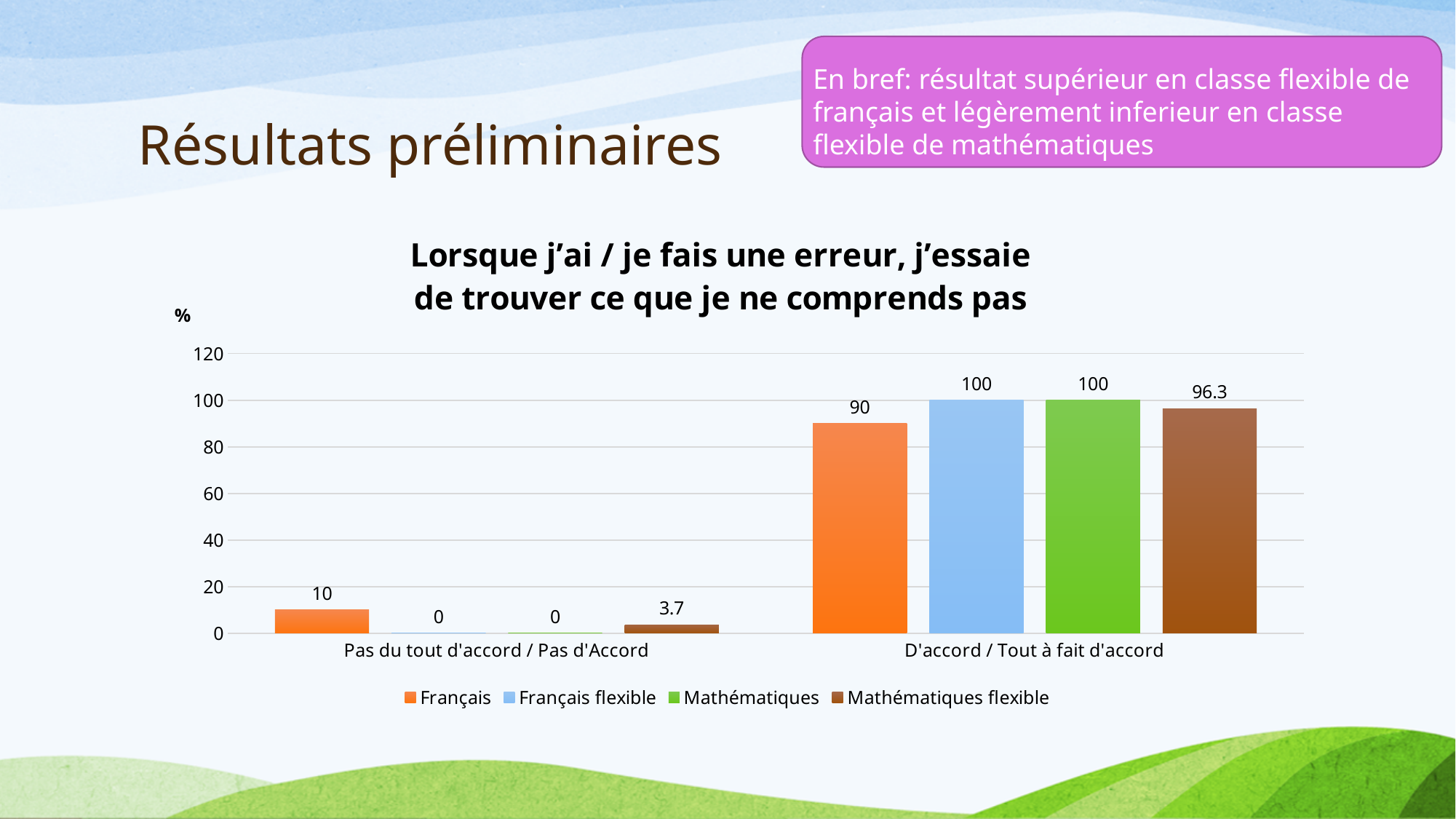
How many series does the legend list? 4 What kind of chart is shown on the slide? Bar chart How many categories are shown on the x axis? 2 What is the value for Mathématiques flexible in the 'D'accord / Tout à fait d'accord' category? 96.3 What is the difference between the Français flexible and Français values in the 'D'accord / Tout à fait d'accord' category? 10 Which series has the lowest value in the 'D'accord / Tout à fait d'accord' category? Français What is the value for Français flexible in the 'D'accord / Tout à fait d'accord' category? 100 In the 'D'accord / Tout à fait d'accord' category, which is larger: Français or Mathématiques flexible? Mathématiques flexible What is the value for Français in the 'D'accord / Tout à fait d'accord' category? 90 Which series has the highest value in the 'Pas du tout d'accord / Pas d'Accord' category? Français What is the value for Mathématiques flexible in the 'Pas du tout d'accord / Pas d'Accord' category? 3.7 What is the difference between the Mathématiques and Mathématiques flexible values in the 'D'accord / Tout à fait d'accord' category? 3.7